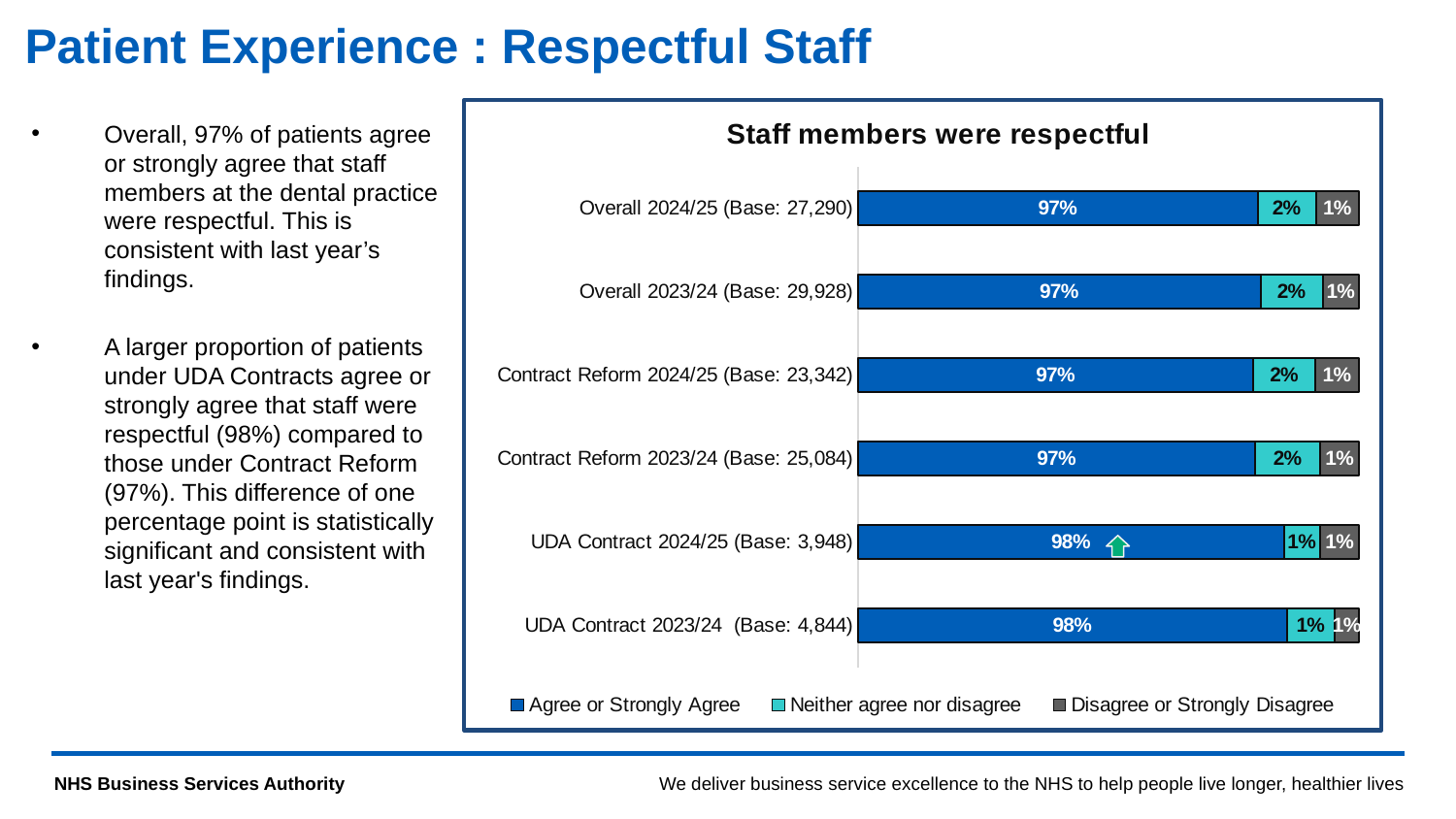
What percentage of patients in UDA Contract 2024/25 agree or strongly agree that staff members were respectful? 98% How many series does the chart legend list? 3 Which is larger, the 'Agree or Strongly Agree' value for UDA Contract 2024/25 or for Overall 2024/25? UDA Contract 2024/25 What percentage of patients in Overall 2024/25 agree or strongly agree that staff members were respectful? 97% What is the 'Neither agree nor disagree' value for UDA Contract 2023/24? 1% What is the 'Disagree or Strongly Disagree' value for Overall 2023/24? 1% What kind of chart is shown on the slide? Stacked bar chart What is the title of the chart? Staff members were respectful What is the base (number of respondents) shown for Contract Reform 2024/25? 23,342 What is the difference in the 'Agree or Strongly Agree' percentage between UDA Contract 2024/25 and Contract Reform 2024/25? 1% What is the 'Neither agree nor disagree' value for Contract Reform 2023/24? 2% How many categories (bars) are shown in the chart? 6